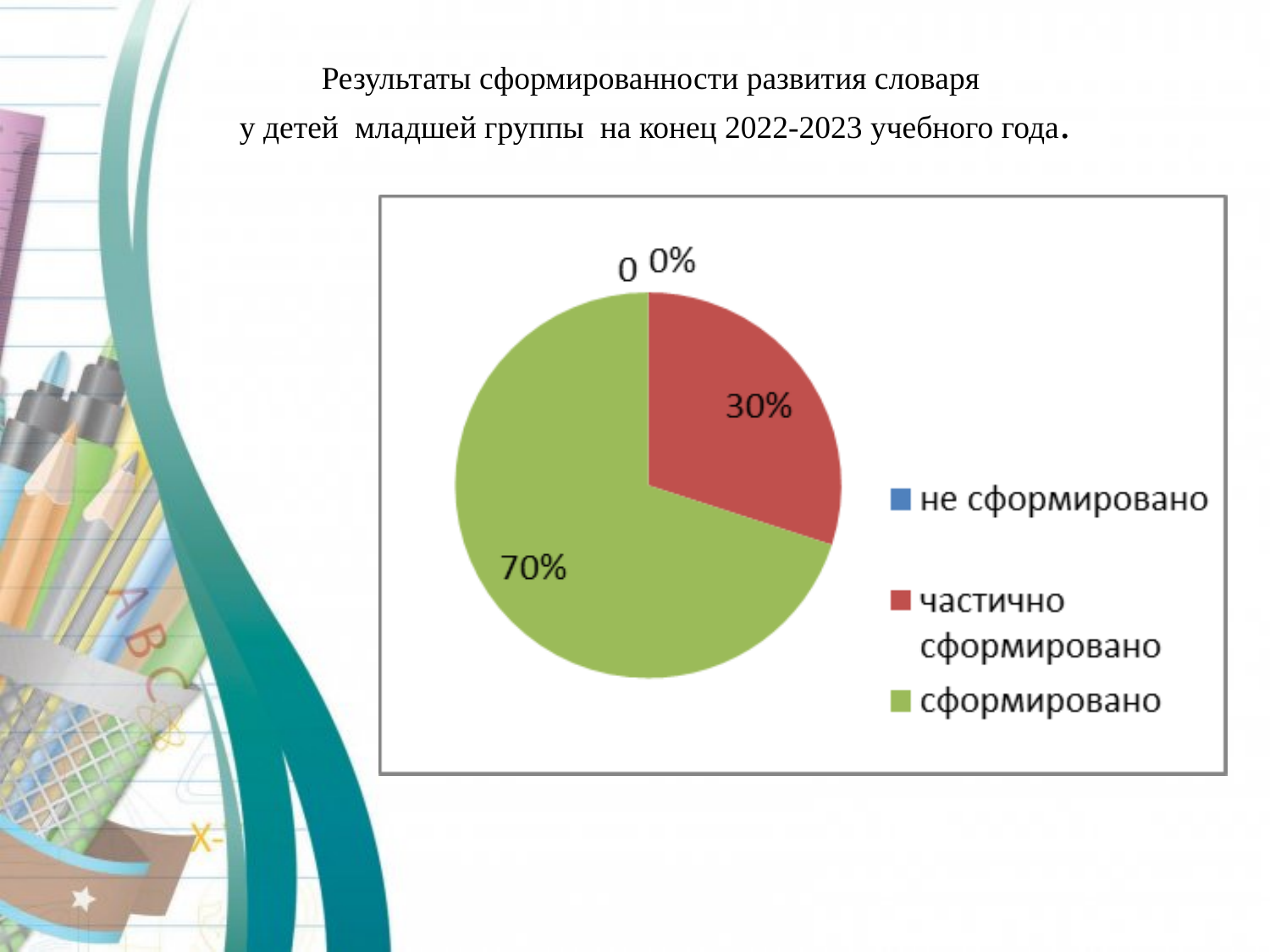
What type of chart is shown on the slide? pie chart Which category has the smallest slice of the pie? не сформировано What colour is the slice for "частично сформировано"? red What share of the pie does "частично сформировано" take? 30% What share of the pie does "не сформировано" take? 0% What is the difference in percentage points between "сформировано" and "частично сформировано"? 40 Which category has the largest slice of the pie? сформировано What share of the pie does "сформировано" take? 70% How many categories does the legend list? 3 What colour is the slice for "сформировано"? green Which is larger: the slice for "сформировано" or the slice for "частично сформировано"? сформировано